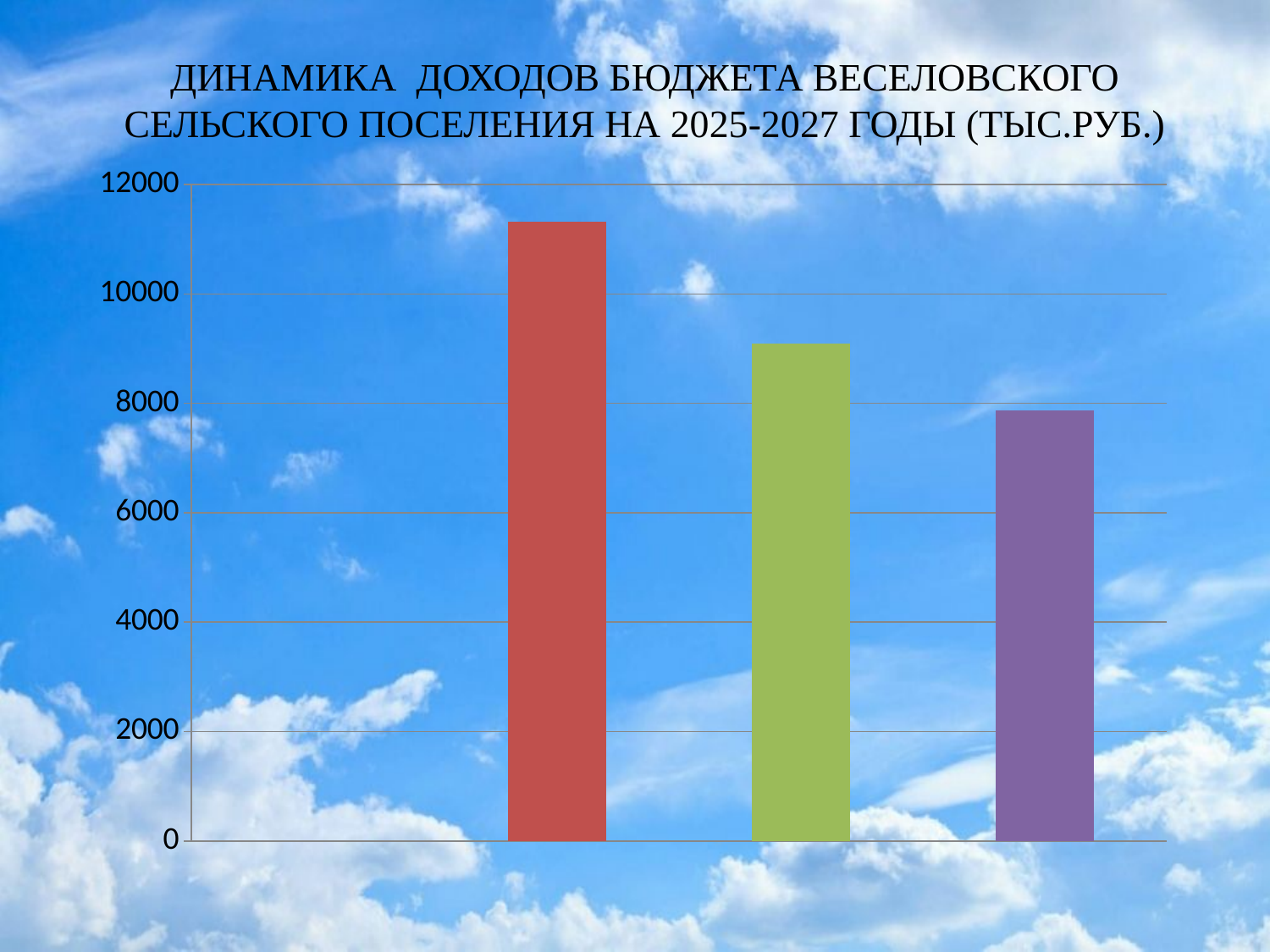
In what units are the values in the chart expressed, according to the title? тыс.руб. Do the bar values rise or fall from left to right across the chart? fall What kind of chart is shown on the slide? bar chart Is the value of the second (green) bar greater or less than 10000? less Which bar is the tallest in the chart? the first (red) bar What is the highest value shown on the vertical axis of the chart? 12000 Is the value of the first (red) bar greater or less than 10000? greater Is the value of the second (green) bar greater or less than 8000? greater Which is larger, the value of the second (green) bar or the third (purple) bar? the second (green) bar How many bars are plotted in the chart? 3 Which bar is the shortest in the chart? the third (purple) bar